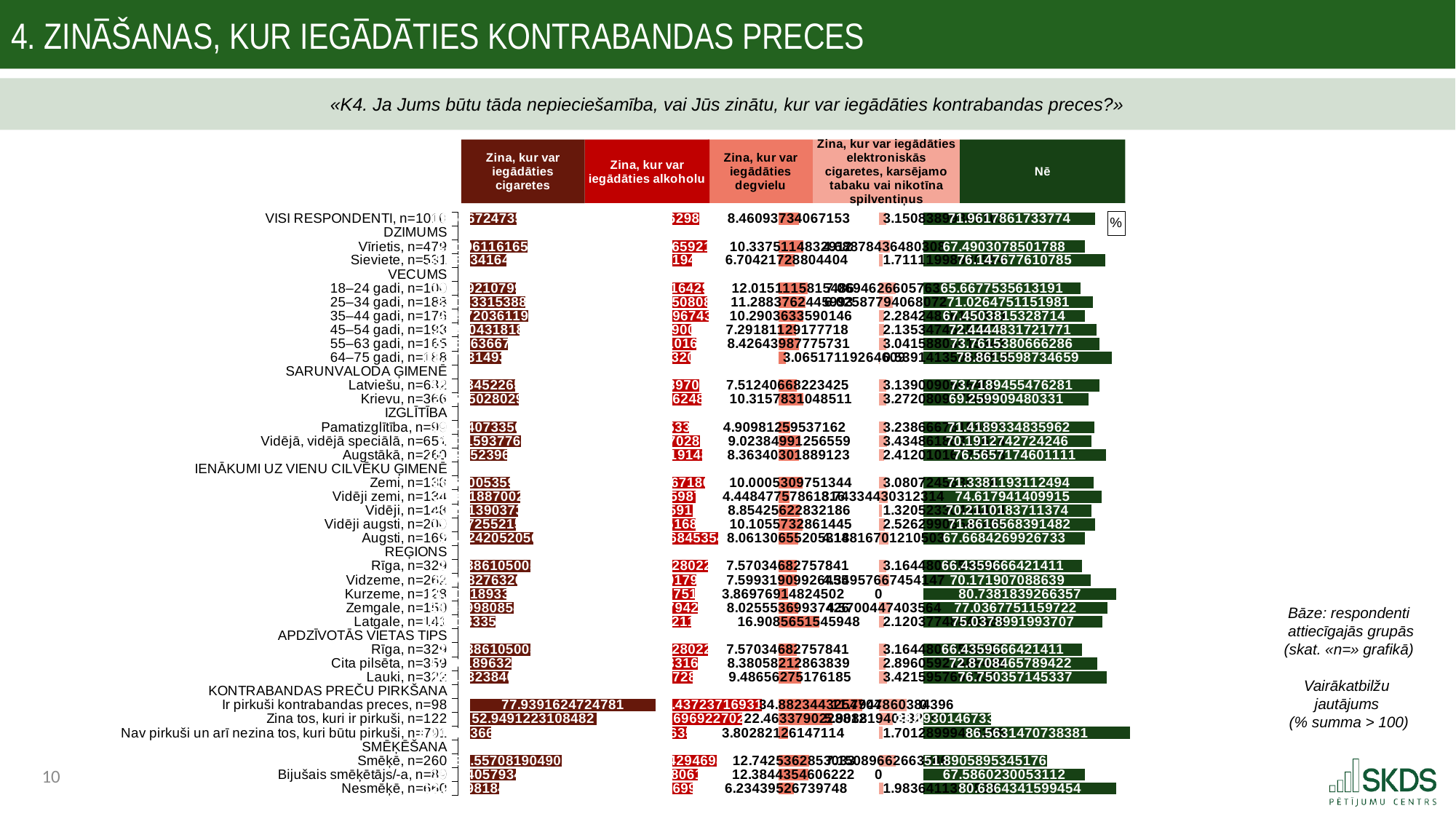
What is the value of the "Zina, kur var iegādāties degvielu" series for "Latgale, n=141"? 16.9085651545948 Which group has the highest value in the "Nē" series? Nav pirkuši un arī nezina tos, kuri būtu pirkuši, n=791 How many series does the chart legend list? 5 What is the difference between the "Nē" values for "Sieviete, n=531" and "Vīrietis, n=479"? 8.6573697606062 What kind of chart is shown on the slide? bar chart What is the value of the "Nē" series for "Sieviete, n=531"? 76.147677610785 What is the value of the "Nē" series for "Vīrietis, n=479"? 67.4903078501788 What is the value of the "Nē" series for "VISI RESPONDENTI, n=1010"? 71.9617861733774 Which has the larger "Nē" value, "Vīrietis, n=479" or "Sieviete, n=531"? Sieviete, n=531 Which colour is used for the "Nē" series in the chart? dark green What is the value of the "Zina, kur var iegādāties elektroniskās cigaretes, karsējamo tabaku vai nikotīna spilventiņus" series for "Kurzeme, n=128"? 0 What is the value of the "Zina, kur var iegādāties cigaretes" series for "Ir pirkuši kontrabandas preces, n=98"? 77.9391624724781